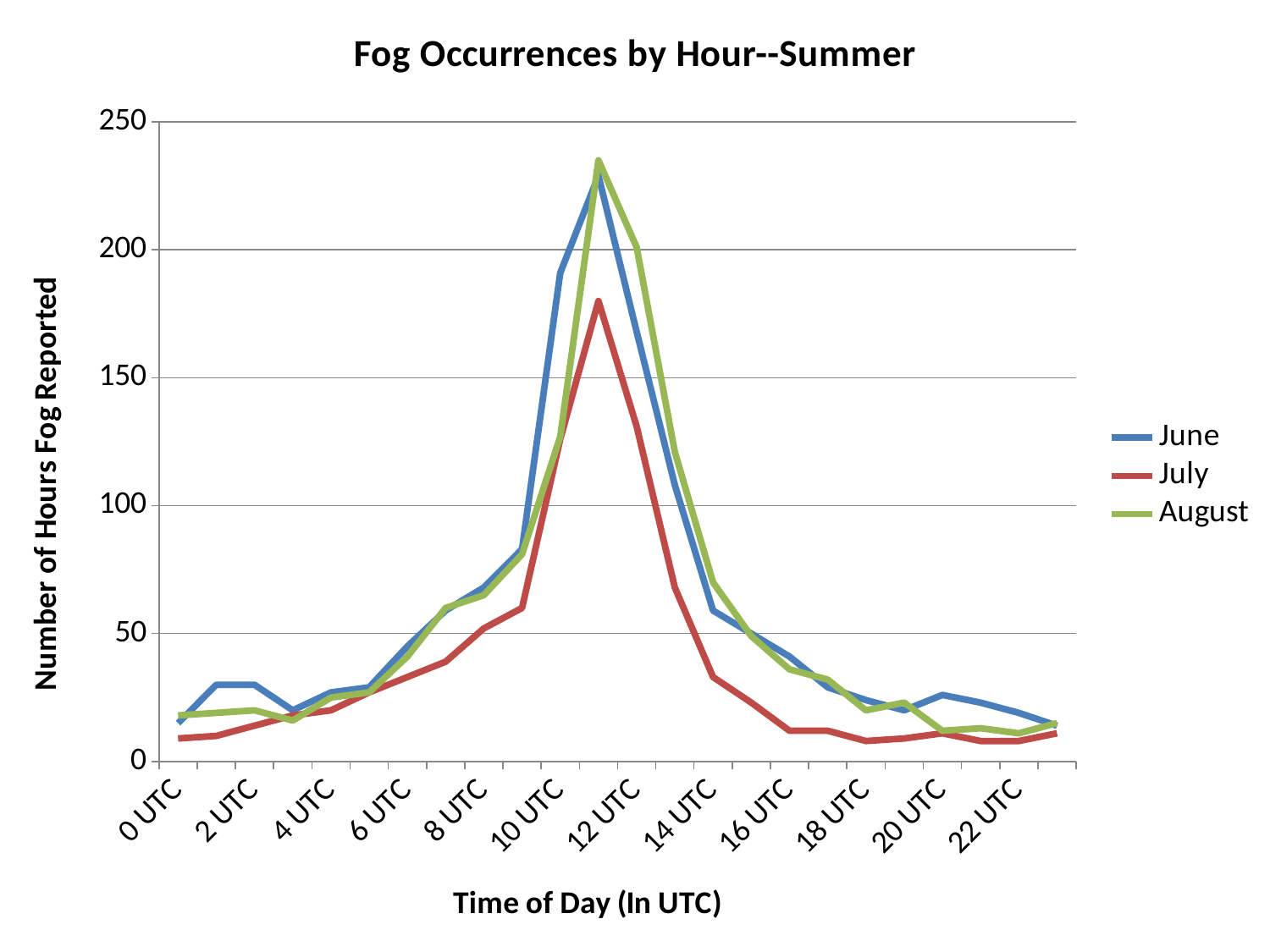
What is the label of the y axis? Number of Hours Fog Reported Is the value for August at 12 UTC greater or less than 150? greater Which series has the lowest value at 11 UTC? July How many series does the legend list? 3 What kind of chart is shown on the slide? Line chart What is the title of the chart? Fog Occurrences by Hour--Summer Is the value for July at 16 UTC greater or less than 50? less How many hour labels are shown along the x axis? 12 At 11 UTC, which series has the higher value, June or July? June Is the value for June at 11 UTC greater or less than 200? greater Do the values for July rise or fall from 11 UTC to 16 UTC? Fall